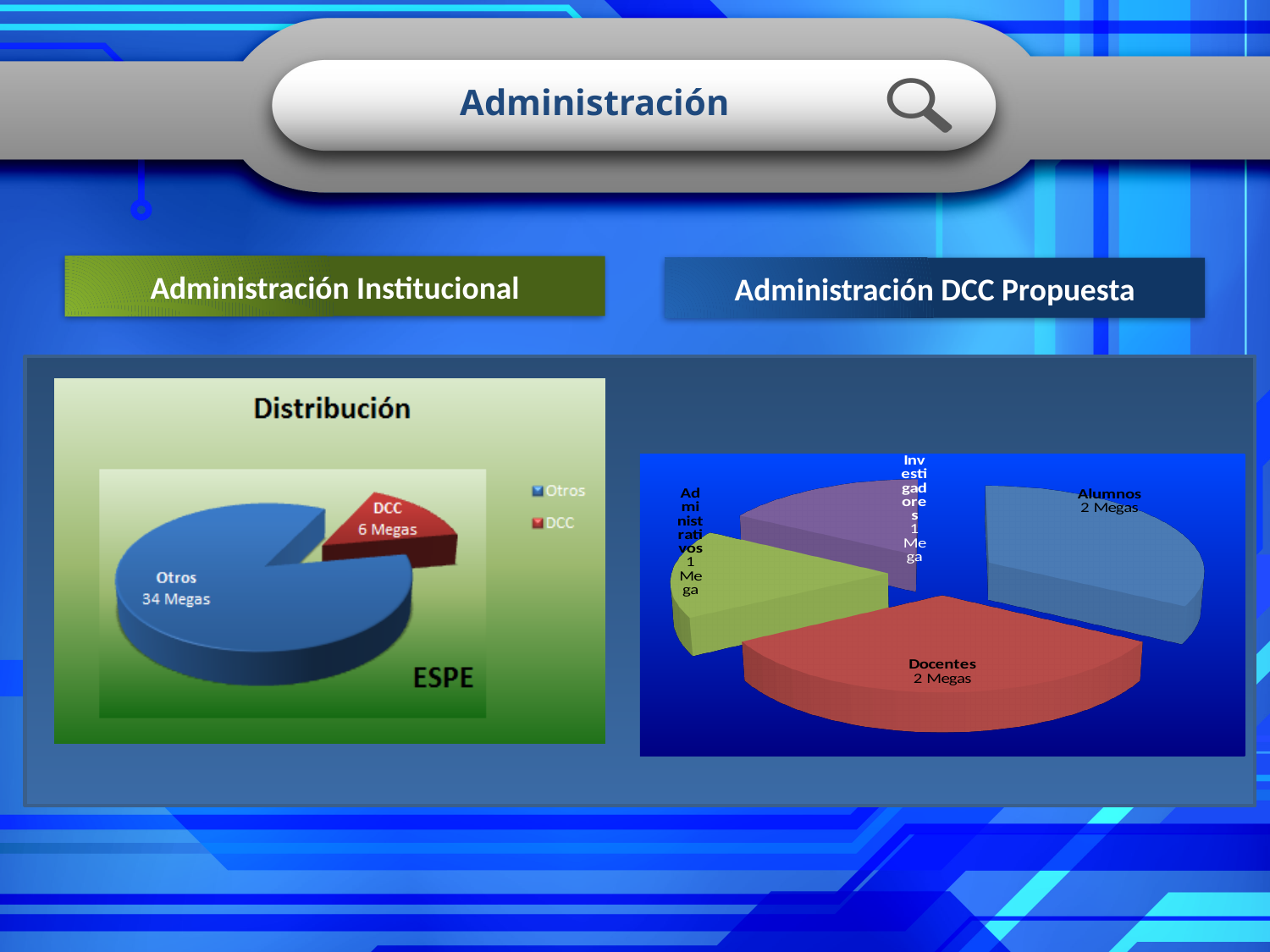
In the right chart under "Administración DCC Propuesta", what is the total of all slices? 6 Megas In the left chart titled "Distribución", what is the value for Otros? 34 Megas In the left chart titled "Distribución", what share of the total does DCC represent? 15% In the right chart under "Administración DCC Propuesta", what is the value for Alumnos? 2 Megas In the left chart titled "Distribución", what is the difference between Otros and DCC? 28 Megas In the right chart under "Administración DCC Propuesta", how many slices does the pie have? 4 In the left chart titled "Distribución", which slice is the largest? Otros In the left chart titled "Distribución", what is the value for DCC? 6 Megas In the right chart under "Administración DCC Propuesta", what is the value for Administrativos? 1 Mega In the left chart titled "Distribución", how many entries does the legend list? 2 In the right chart under "Administración DCC Propuesta", which is larger, Docentes or Investigadores? Docentes What kind of chart is the right chart under "Administración DCC Propuesta"? Pie chart